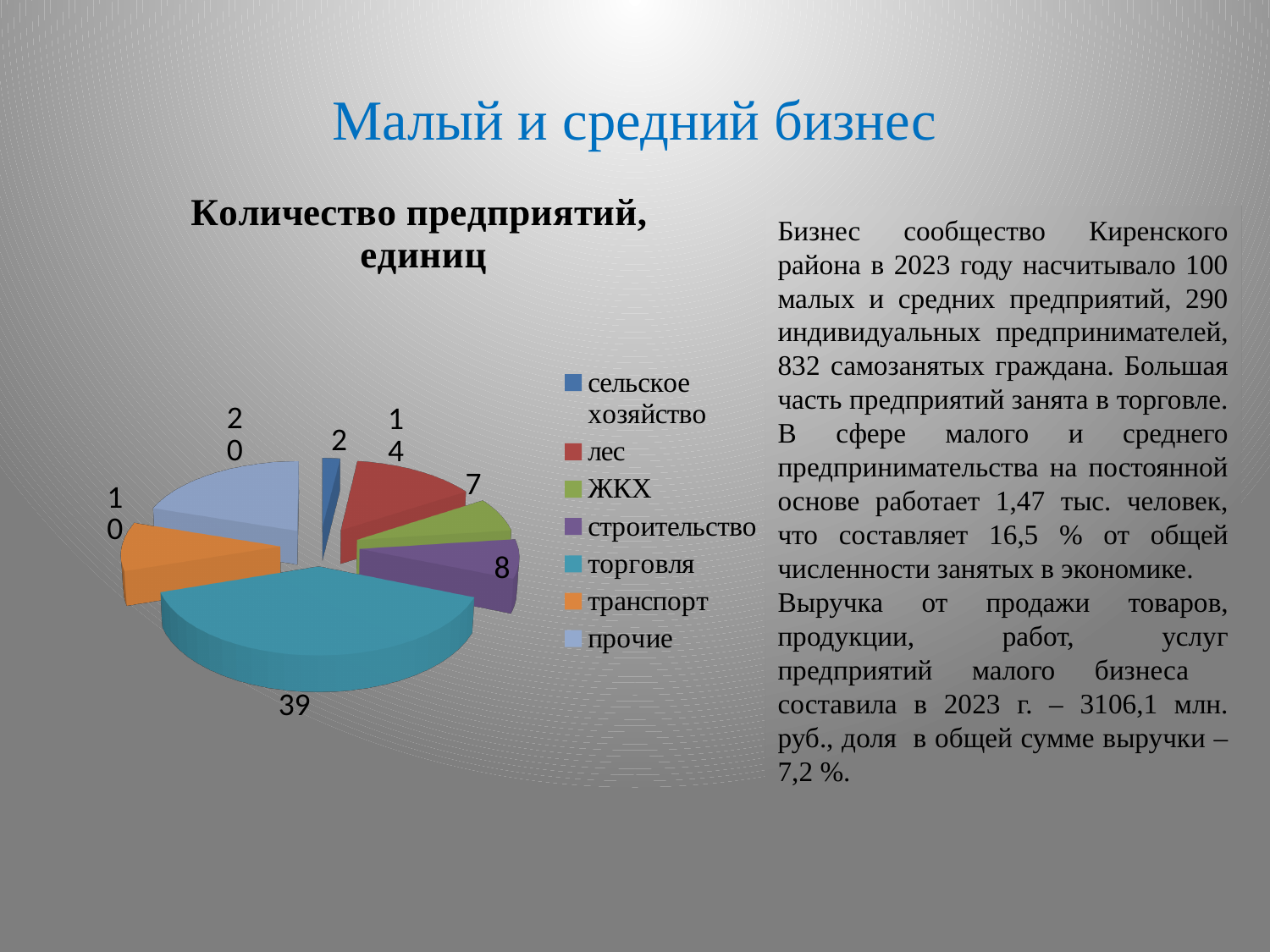
What type of chart is shown on the slide? pie chart Which category has the largest slice in the pie chart? торговля What is the value for торговля in the chart? 39 What is the value for лес in the chart? 14 What is the value for прочие in the chart? 20 What share of the total does торговля represent in the pie chart? 39% How many categories does the pie chart show? 7 Which category has the smallest slice in the pie chart? сельское хозяйство Which is larger, the value for строительство or the value for ЖКХ? строительство What is the difference between the values for торговля and прочие? 19 What is the title of the chart? Количество предприятий, единиц What is the value for транспорт in the chart? 10